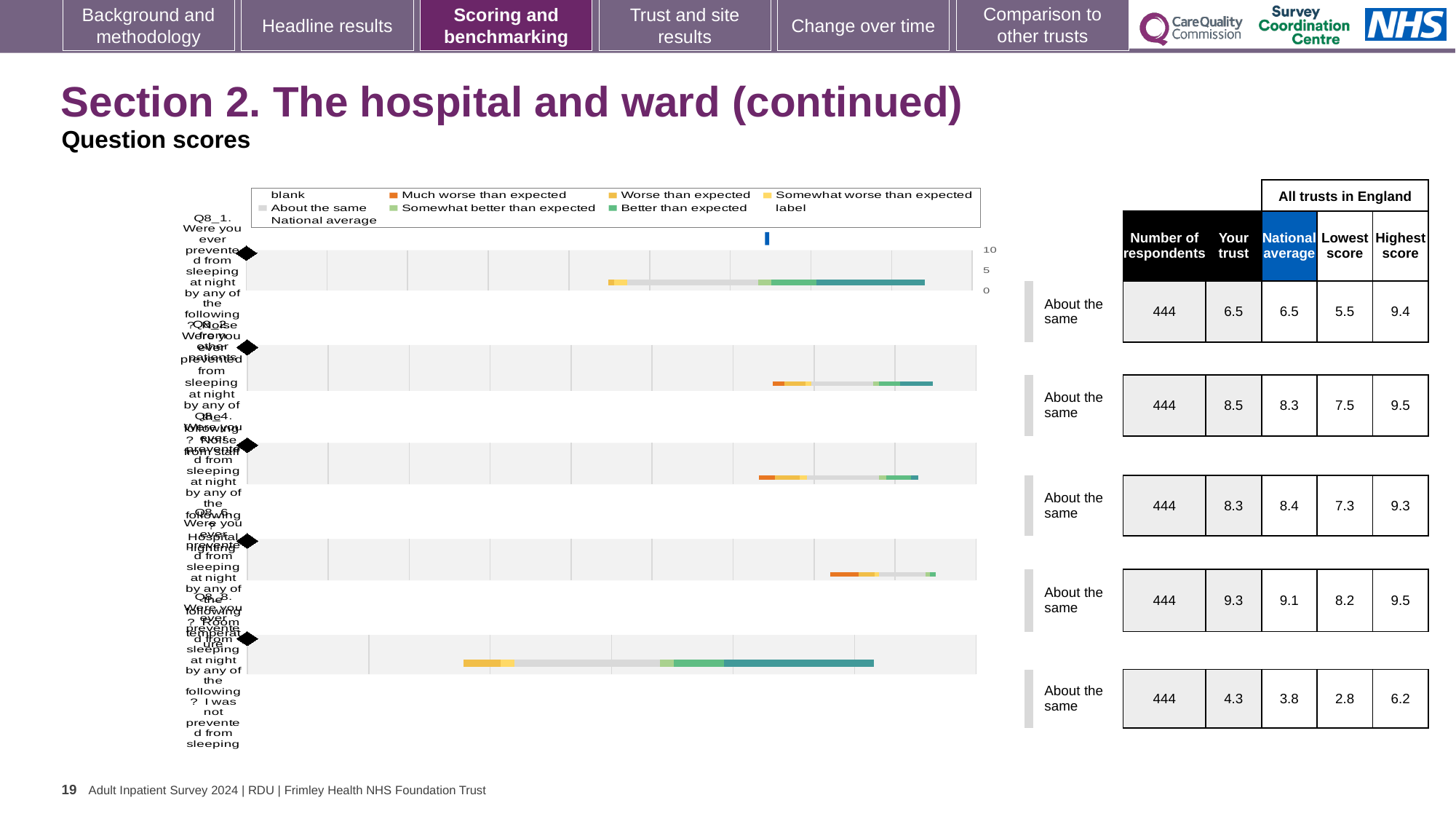
What benchmark category is shown next to every chart on the slide? About the same How many question bars (charts) are shown on the slide? 5 What kind of chart is used to show the question scores on this slide? Bar chart (horizontal stacked bars) For the second chart (Q8_2), what is the difference between the 'Your trust' score and the national average? 0.2 For the top chart (Q8_1), what is the 'Your trust' score shown? 6.5 Which chart has the highest 'Your trust' score? The fourth chart (Q8_6), 9.3 For the second chart (Q8_2), what is the highest score among all trusts in England? 9.5 For the bottom chart (Q8_8), what is the national average score shown? 3.8 Which legend entry is shown in the darkest teal/green colour? Better than expected Which chart has the lowest 'Your trust' score? The bottom chart (Q8_8), 4.3 How many respondents are shown for each question on the slide? 444 For the third chart (Q8_4), which is larger: the 'Your trust' score or the national average? National average (8.4)